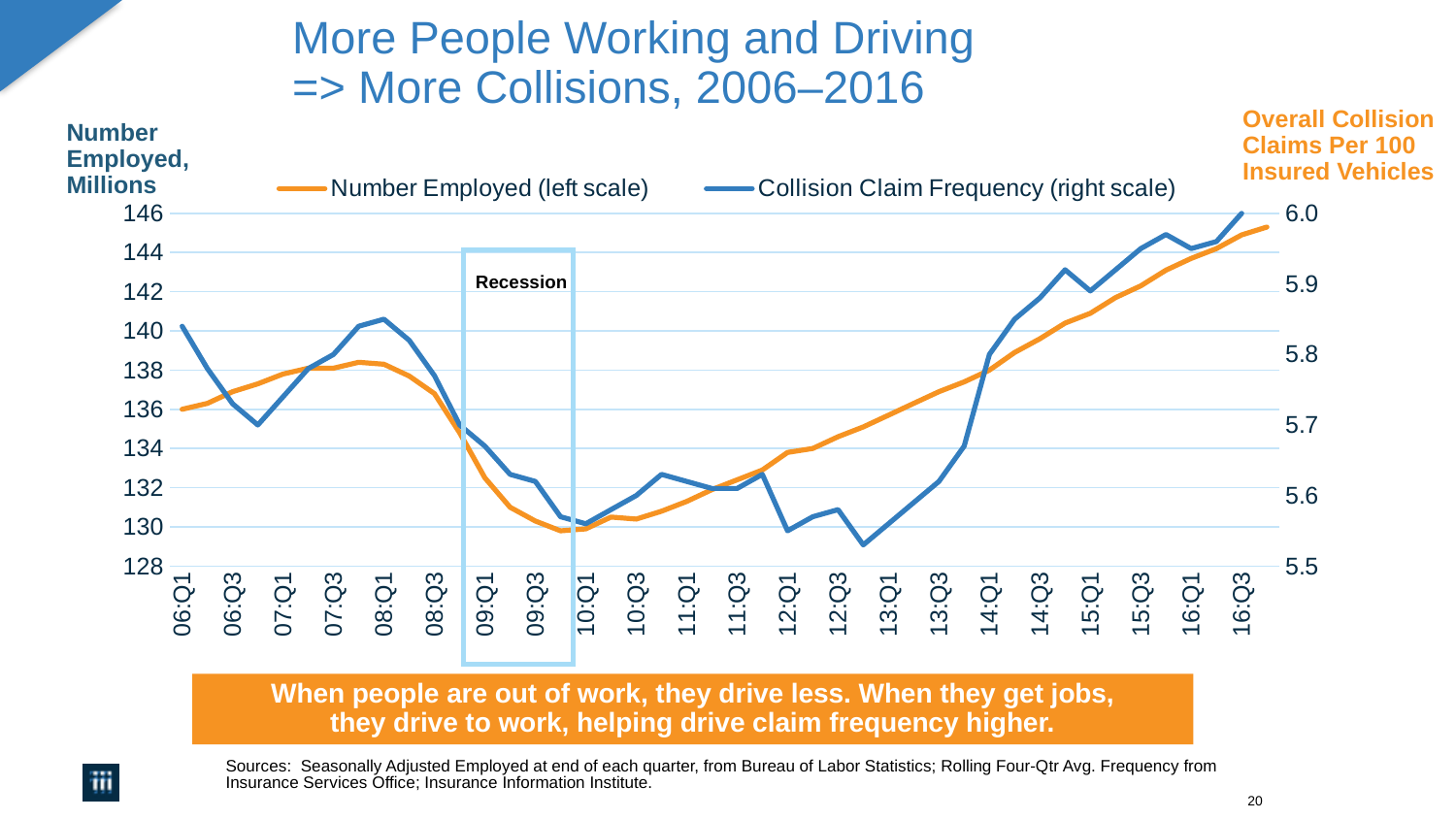
Does the Number Employed series rise or fall from 10:Q1 to 16:Q3? rise Is the value for Number Employed at 16:Q3 greater or less than 144? greater Is the value for Collision Claim Frequency at 16:Q3 greater or less than 5.9? greater Is the value for Collision Claim Frequency at 06:Q1 greater or less than 5.8? greater Which series is plotted against the right scale? Collision Claim Frequency Does the Number Employed series rise or fall from 08:Q1 to 09:Q3? fall How many series does the legend list? 2 What kind of chart is shown on the slide? Line chart At which quarter does the Collision Claim Frequency series reach its highest value? 16:Q3 What label appears inside the highlighted box around 09:Q1 to 09:Q4? Recession